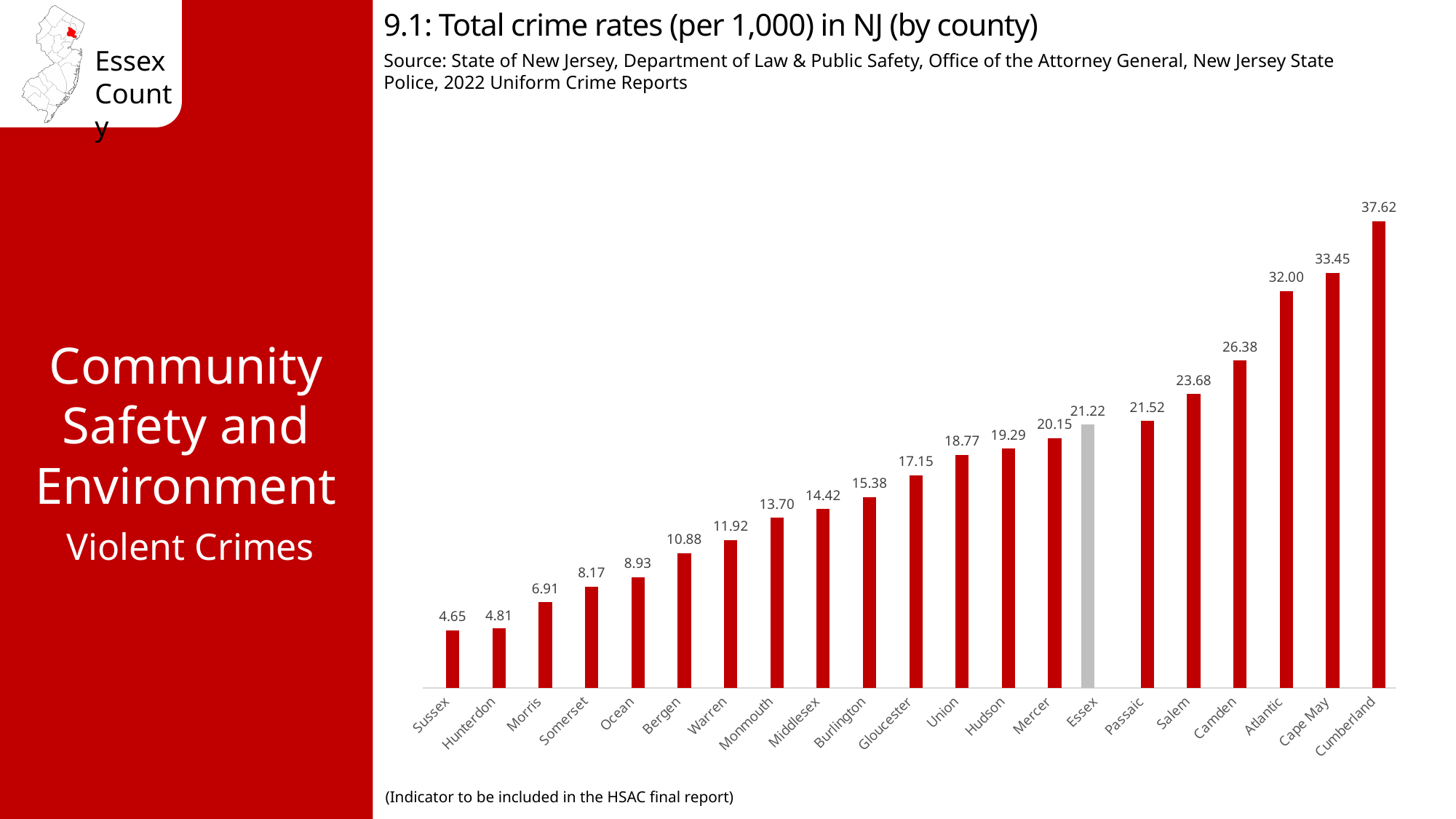
Which county has the lowest total crime rate? Sussex What is the difference between the total crime rates of Essex and Mercer? 1.07 Which county has a higher total crime rate, Atlantic or Cape May? Cape May What is the difference between the total crime rates of Cumberland and Sussex? 32.97 What kind of chart is used to show the total crime rates? Bar chart Which county has a higher total crime rate, Morris or Warren? Warren What is the total crime rate per 1,000 for Essex County? 21.22 What is the total crime rate per 1,000 for Bergen County? 10.88 Do the values rise or fall from left to right along the x axis? Rise Which county has the highest total crime rate? Cumberland How many counties are shown in the chart? 21 What is the total crime rate per 1,000 for Camden County? 26.38